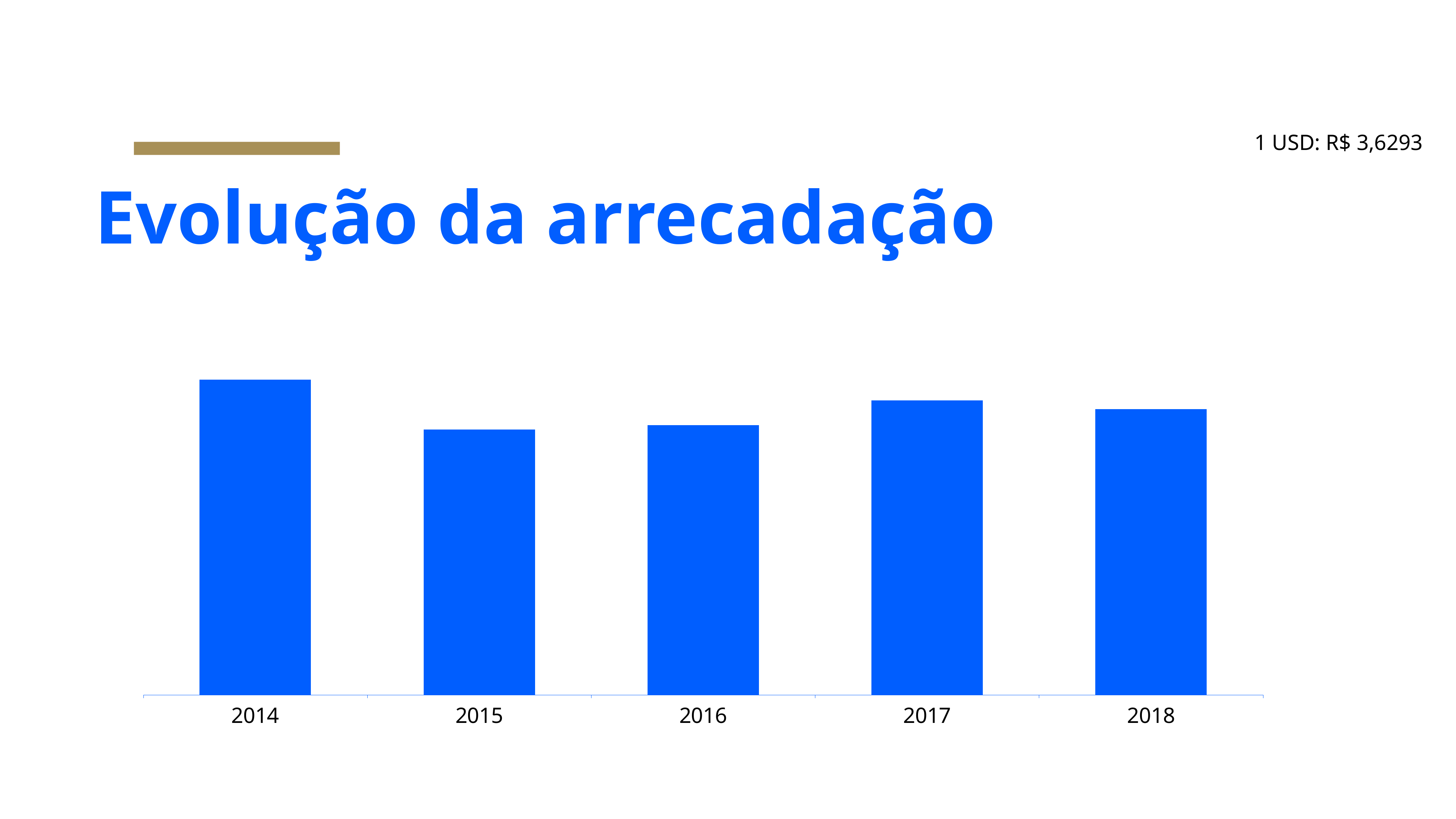
What kind of chart is shown on the slide? bar chart Does the value rise or fall from 2016 to 2017? rise Which year has the larger value, 2014 or 2015? 2014 Does the value rise or fall from 2014 to 2015? fall Which year has the highest bar in the chart? 2014 Which year has the larger value, 2015 or 2017? 2017 How many years are shown on the x axis of the chart? 5 Which year has the lowest bar in the chart? 2015 What is the title of the chart on the slide? Evolução da arrecadação Which year has the larger value, 2014 or 2018? 2014 What exchange rate is noted in the top right corner of the slide? 1 USD: R$ 3,6293